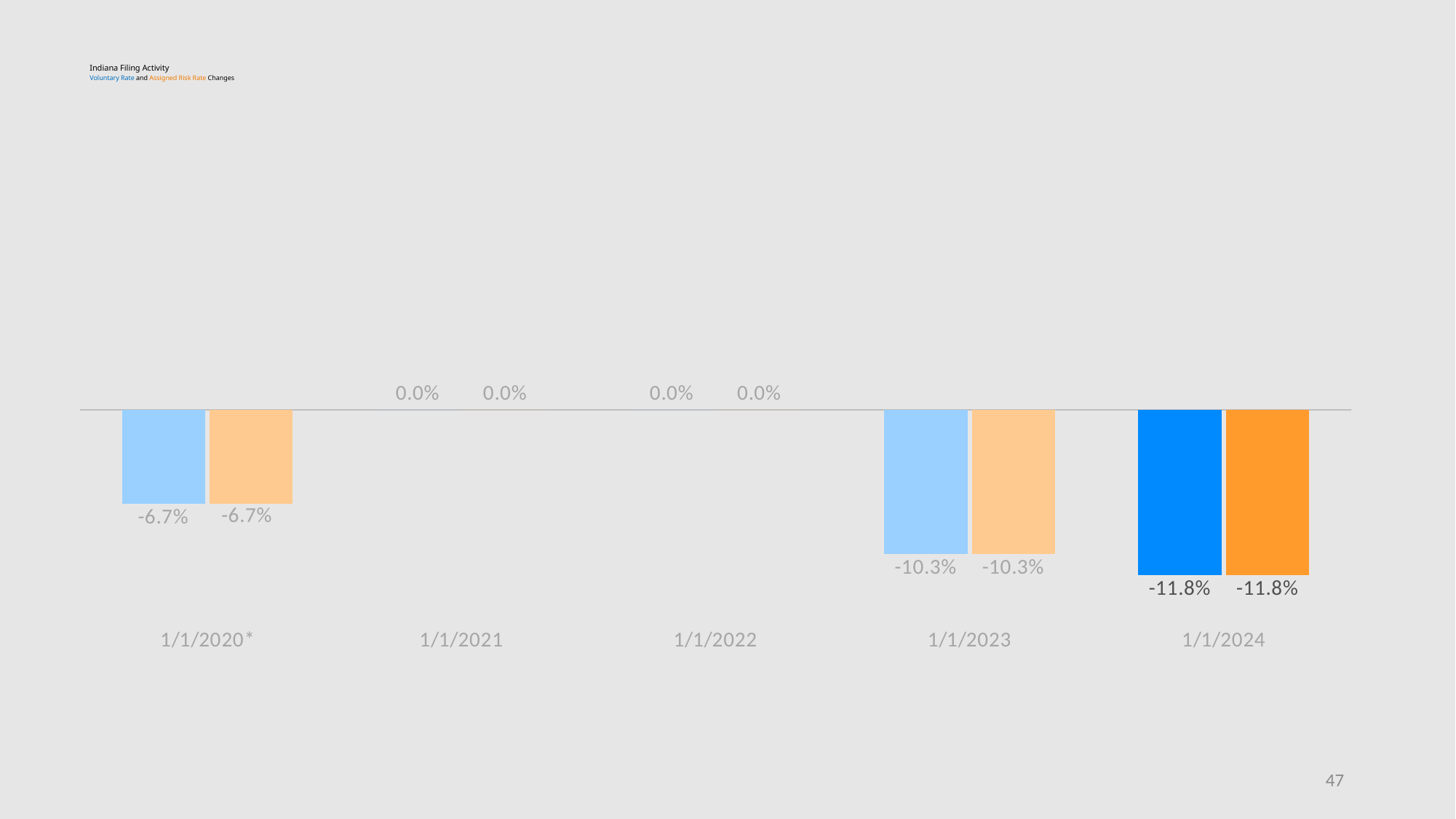
What kind of chart is shown on the slide? Bar chart What is the difference between the Assigned Risk Rate change for 1/1/2023 and for 1/1/2020*? 3.6 percentage points Which is larger, the Voluntary Rate change for 1/1/2020* or for 1/1/2023? 1/1/2020* Which date has the lowest Voluntary Rate change? 1/1/2024 What is the Voluntary Rate change for 1/1/2024? -11.8% How many series does the chart show? 2 What is the Assigned Risk Rate change for 1/1/2021? 0.0% What is the Voluntary Rate change for 1/1/2020*? -6.7% What is the difference between the Voluntary Rate change for 1/1/2024 and for 1/1/2023? 1.5 percentage points What is the title of the chart? Indiana Filing Activity What is the Assigned Risk Rate change for 1/1/2023? -10.3% How many dates are shown on the x axis? 5